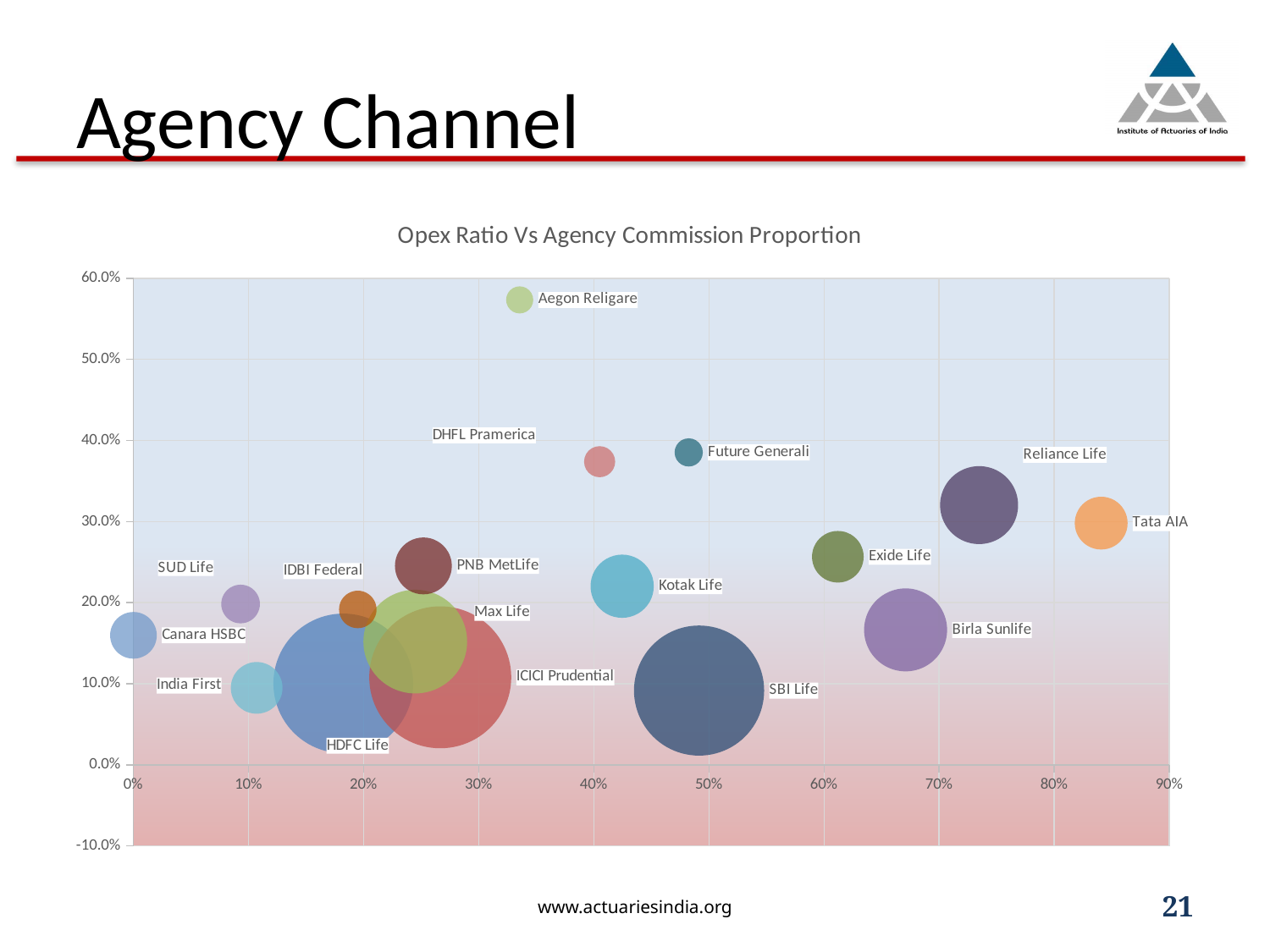
Is the vertical-axis value for Aegon Religare greater or less than 50.0%? greater Which company has the highest opex ratio (the highest bubble on the vertical axis)? Aegon Religare What kind of chart is shown on the slide? Bubble chart Which has the higher vertical-axis value, Reliance Life or Exide Life? Reliance Life Which company is plotted furthest to the right on the horizontal axis? Tata AIA What is the title of the chart? Opex Ratio Vs Agency Commission Proportion Is the horizontal-axis value for Tata AIA greater or less than 80%? greater Is the horizontal-axis value for SBI Life greater or less than 40%? greater Which company is plotted furthest to the left on the horizontal axis? Canara HSBC How many labelled bubbles (companies) are plotted on the chart? 17 Which has the higher vertical-axis value, Future Generali or Kotak Life? Future Generali